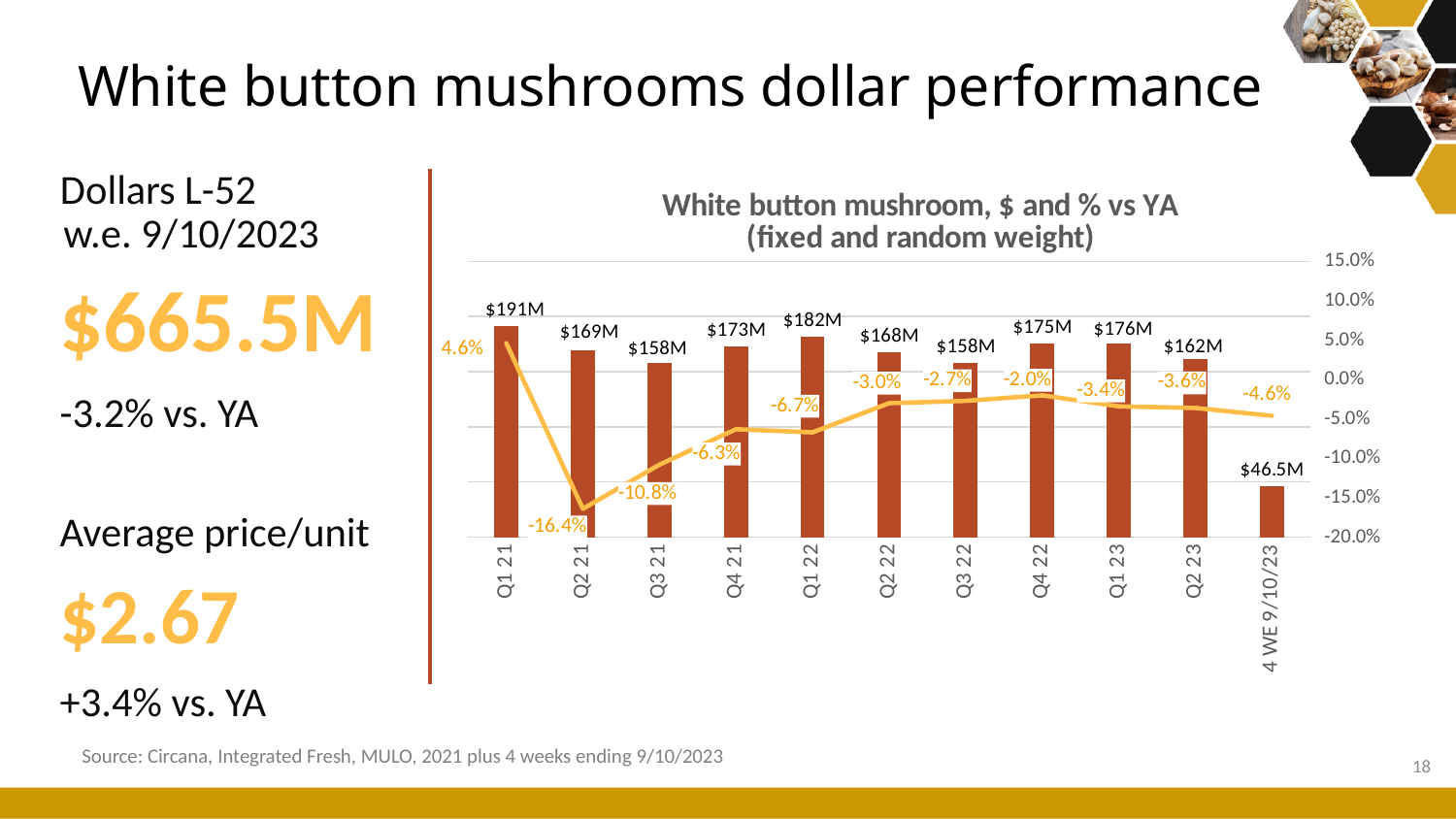
What is the title of the chart? White button mushroom, $ and % vs YA (fixed and random weight) Which period has the lowest % vs YA value? Q2 21 What is the % vs YA value for Q4 22? -2.0% What is the dollar value for the 4 WE 9/10/23 period? $46.5M Which quarter has the highest dollar value? Q1 21 What is the difference in dollars between Q1 22 and Q2 22? $14M What is the dollar value for Q1 21? $191M What is the % vs YA value for Q2 21? -16.4% Which has a higher dollar value, Q4 22 or Q1 23? Q1 23 How many periods are shown on the x axis? 11 Does the % vs YA line rise or fall from Q2 21 to Q4 22? Rise What kind of chart is this? Combined bar and line chart